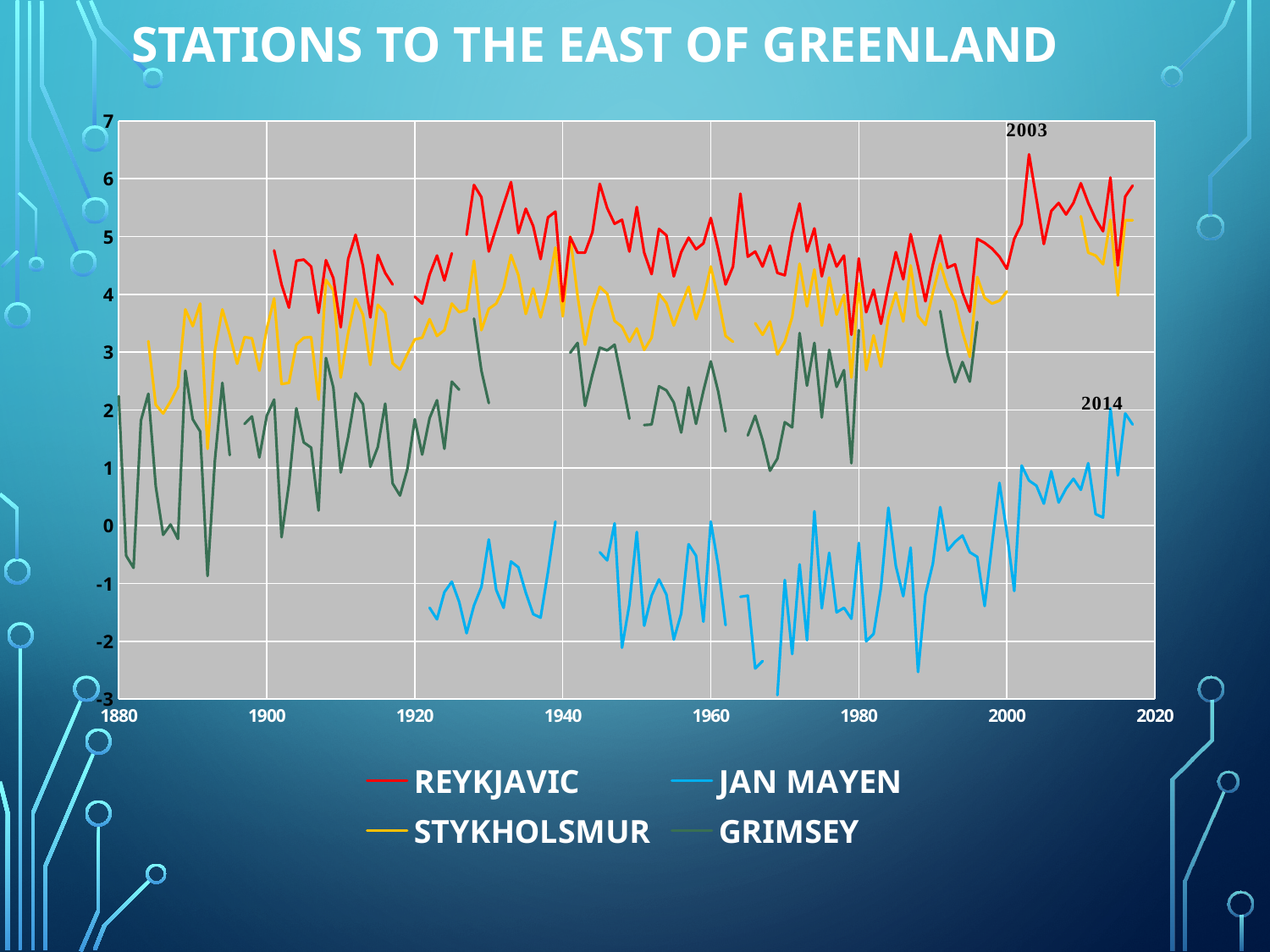
What kind of chart is shown on the slide? Line chart What is the title of the chart? Stations to the East of Greenland In which year does the Jan Mayen series reach its labelled peak? 2014 Which series has the highest values overall on the chart? Reykjavic Is the value for Jan Mayen in 2014 greater or less than 1? greater Do the Jan Mayen values generally rise or fall from the 1920s to the 2010s? rise Which series has the lowest values overall on the chart? Jan Mayen Is the peak value for Reykjavic in 2003 greater or less than 6? greater How many series does the legend list? 4 Is the value for Jan Mayen around 1970 greater or less than 0? less Around 1960, which series is higher, Reykjavic or Jan Mayen? Reykjavic In which year does the Reykjavic series reach its labelled peak? 2003